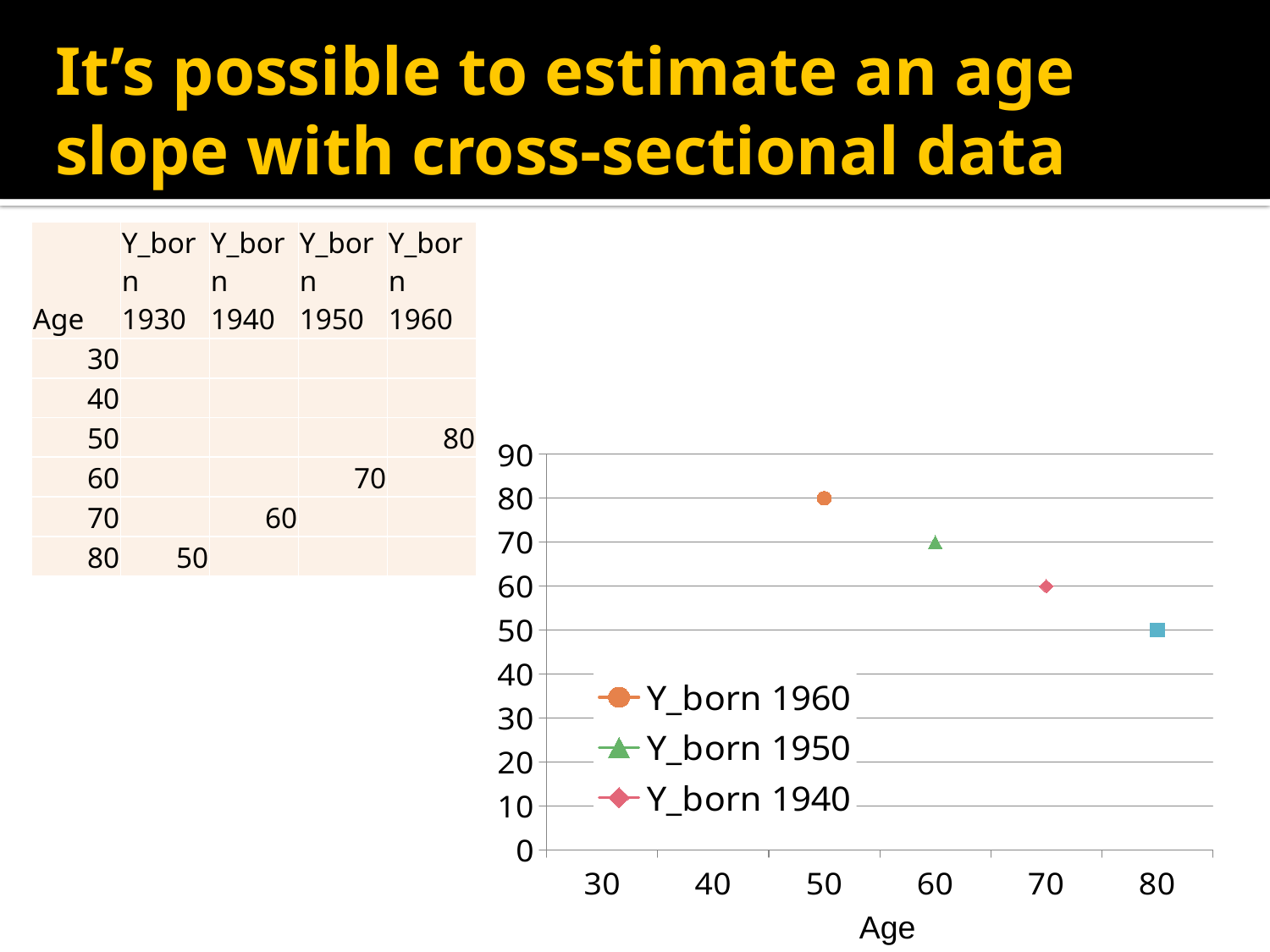
How many series does the chart legend list? 3 Which is larger, the value for Y_born 1950 or the value for Y_born 1940? Y_born 1950 What type of chart is shown on the slide? scatter chart What is the value of the point plotted at age 80? 50 What is the value plotted for Y_born 1960 at age 50? 80 What is the value plotted for Y_born 1940 at age 70? 60 What is the difference between the value for Y_born 1960 and the value for Y_born 1940? 20 How many data points are plotted on the chart? 4 What is the label of the x axis? Age Do the plotted values rise or fall as age increases along the x axis? fall Which series has the highest plotted value? Y_born 1960 What is the value plotted for Y_born 1950 at age 60? 70